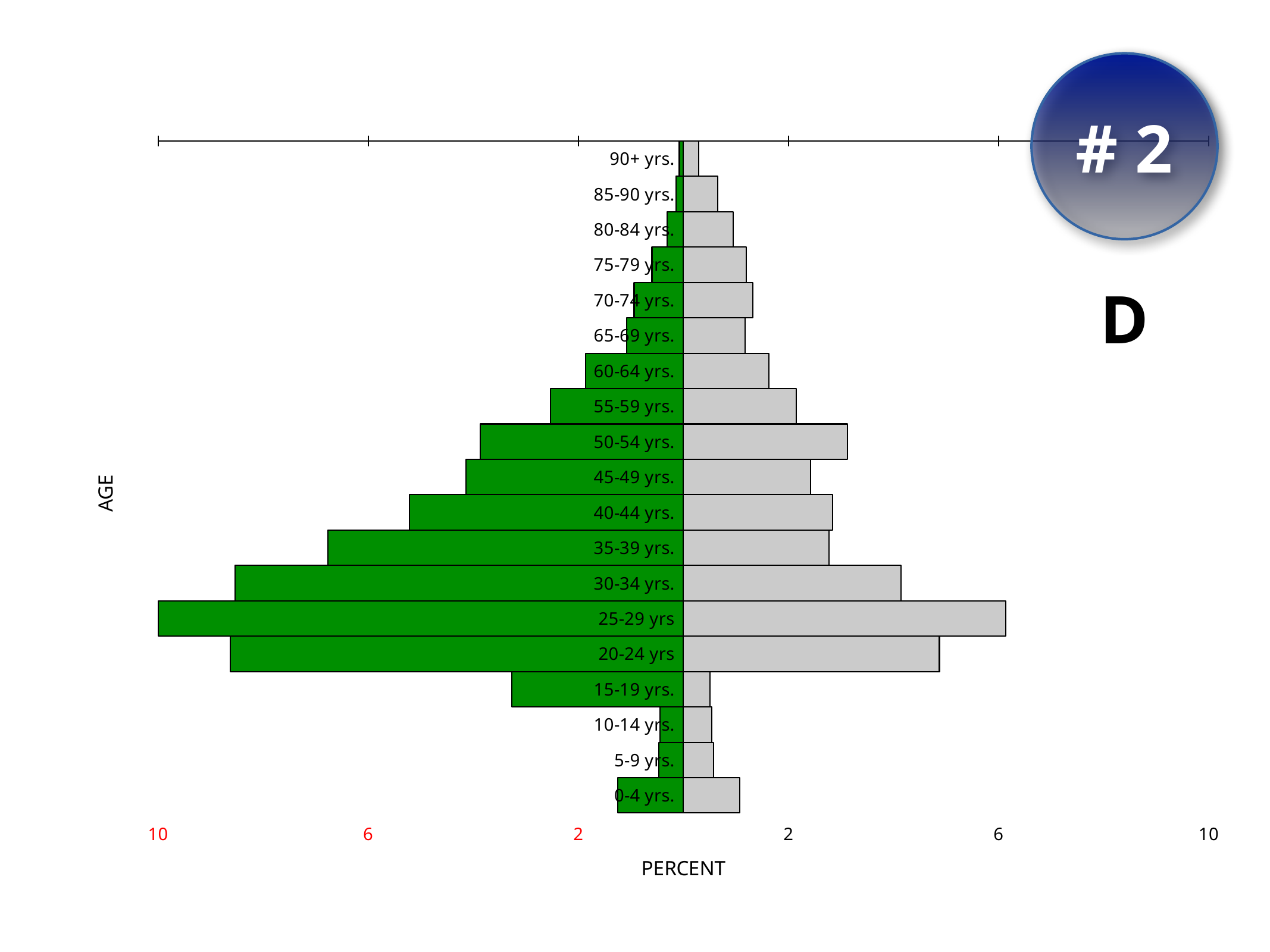
For the 25-29 yrs age group, which bar is longer, the green one or the grey one? green How many age groups are shown on the chart? 19 Is the grey bar for 20-24 yrs greater or less than 6 percent? less Which age group has the shortest green bar? 90+ yrs. Is the green bar for 25-29 yrs greater or less than 6 percent? greater Is the grey bar for 15-19 yrs. greater or less than 2 percent? less Which age group has the longest grey bar? 25-29 yrs What is the label of the vertical axis? AGE What kind of chart is shown on the slide? bar chart Which age group has the longest green bar? 25-29 yrs What is the label of the horizontal axis? PERCENT